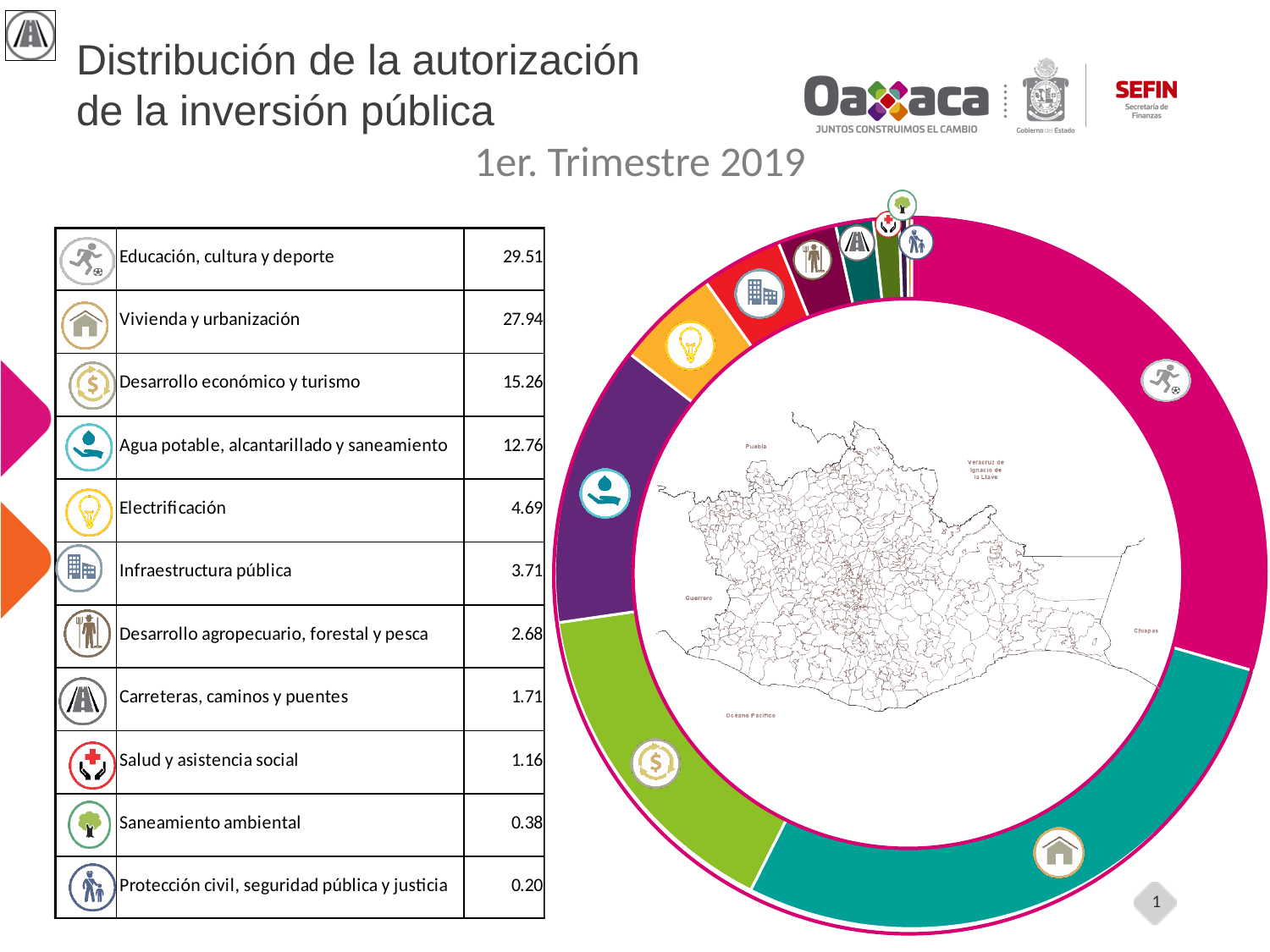
What is the value for Agua potable, alcantarillado y saneamiento? 12.76 Which category has the highest value? Educación, cultura y deporte What is the value for Educación, cultura y deporte? 29.51 What is the difference between the values for Infraestructura pública and Desarrollo agropecuario, forestal y pesca? 1.03 What is the value for Electrificación? 4.69 What kind of chart is shown on the slide? Donut chart What is the value for Vivienda y urbanización? 27.94 What is the difference between the values for Educación, cultura y deporte and Vivienda y urbanización? 1.57 What period does the chart cover, according to the subtitle? 1er. Trimestre 2019 Which category has the lowest value? Protección civil, seguridad pública y justicia Which is larger, the value for Desarrollo económico y turismo or the value for Agua potable, alcantarillado y saneamiento? Desarrollo económico y turismo How many categories are listed in the table next to the donut chart? 11